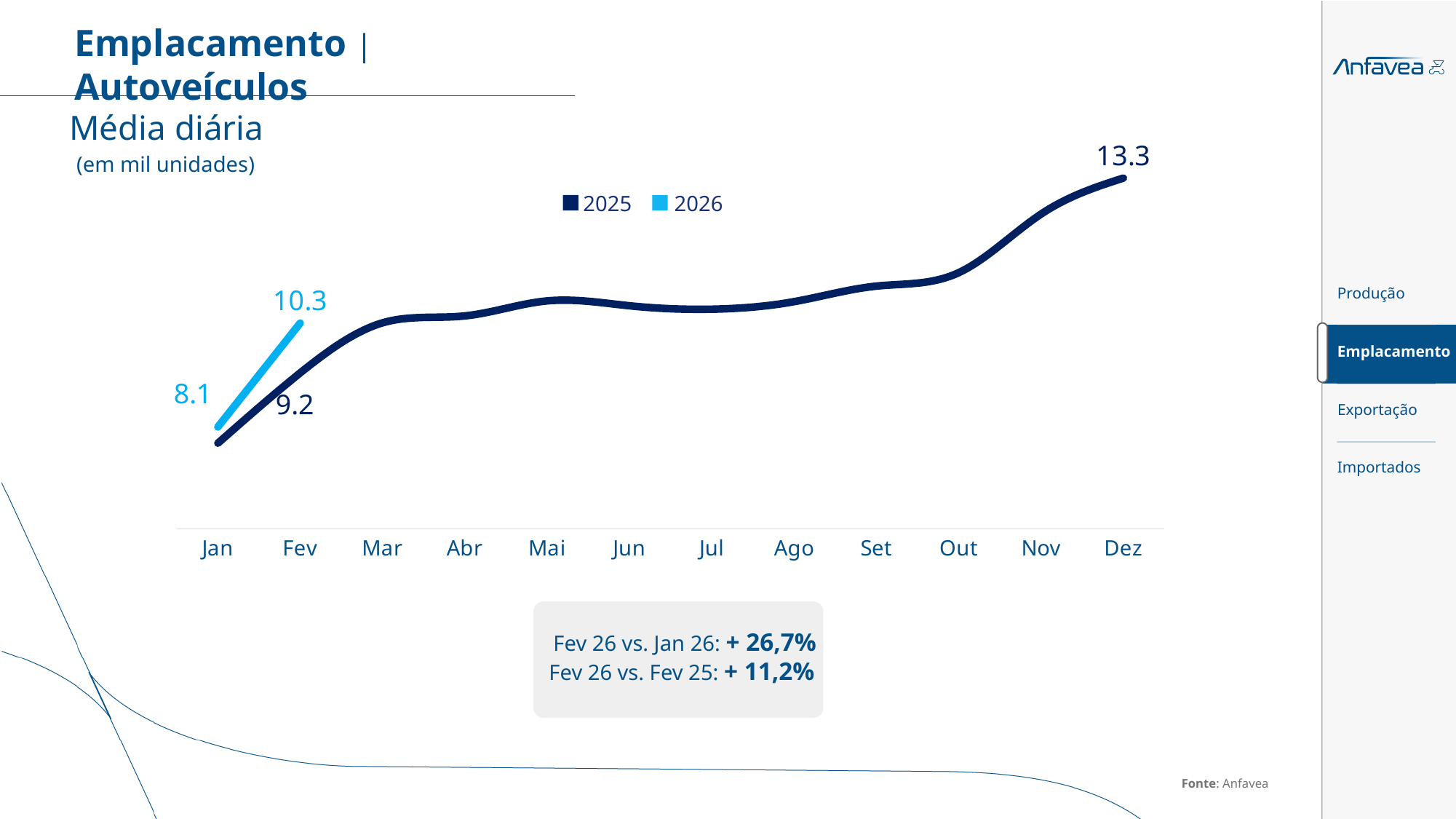
Does the 2025 series rise or fall overall from Jan to Dez? rise How many series does the legend list? 2 What is the value for Dez in the 2025 series? 13.3 What is the difference between the Fev and Jan values in the 2026 series? 2.2 How many months are shown on the x axis? 12 Which month has the highest value in the 2025 series? Dez Which series has the larger value for Fev, 2025 or 2026? 2026 What is the difference between the Fev 2026 value and the Fev 2025 value? 1.1 What kind of chart is shown on the slide? line chart What is the value for Fev in the 2025 series? 9.2 What is the value for Jan in the 2026 series? 8.1 What is the value for Fev in the 2026 series? 10.3